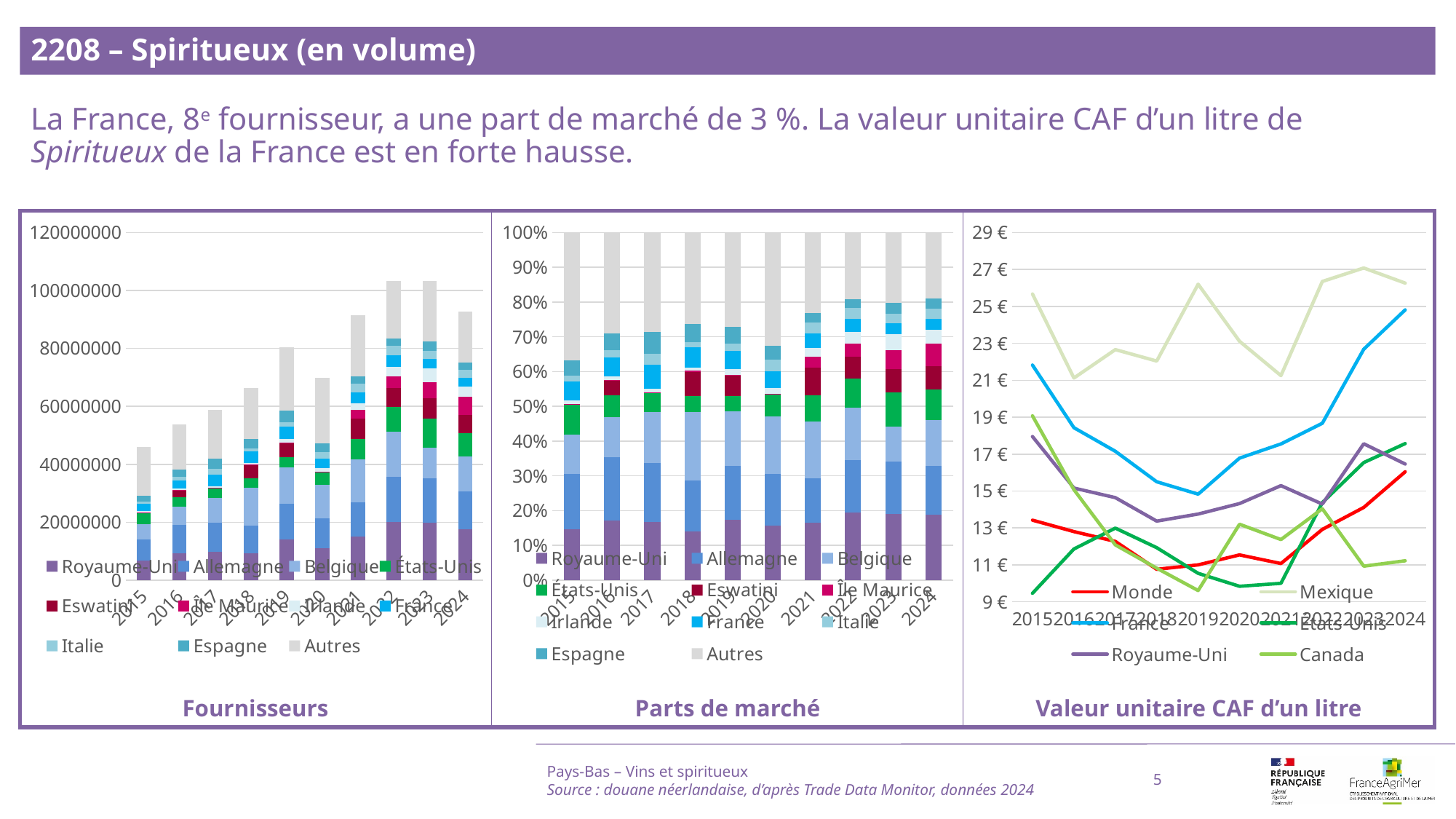
In the 'Fournisseurs' chart, which year has the lowest total bar? 2015 What kind of chart is the 'Valeur unitaire CAF d'un litre' chart? Line chart How many series does the legend of the 'Valeur unitaire CAF d'un litre' chart list? 6 How many series does the legend of the 'Fournisseurs' chart list? 11 In the 'Valeur unitaire CAF d'un litre' chart, is the value for Canada in 2015 greater or less than 11 €? greater In the 'Valeur unitaire CAF d'un litre' chart, is the value for Mexique in 2023 greater or less than 25 €? greater How many years are shown on the x axis of the 'Parts de marché' chart? 10 In the 'Valeur unitaire CAF d'un litre' chart, which series has the highest value in 2024? Mexique In the 'Valeur unitaire CAF d'un litre' chart, which series has the lowest value in 2024? Canada In the 'Fournisseurs' chart, is the total for 2024 greater or less than 80000000? greater What kind of chart is the 'Fournisseurs' chart? Stacked bar chart